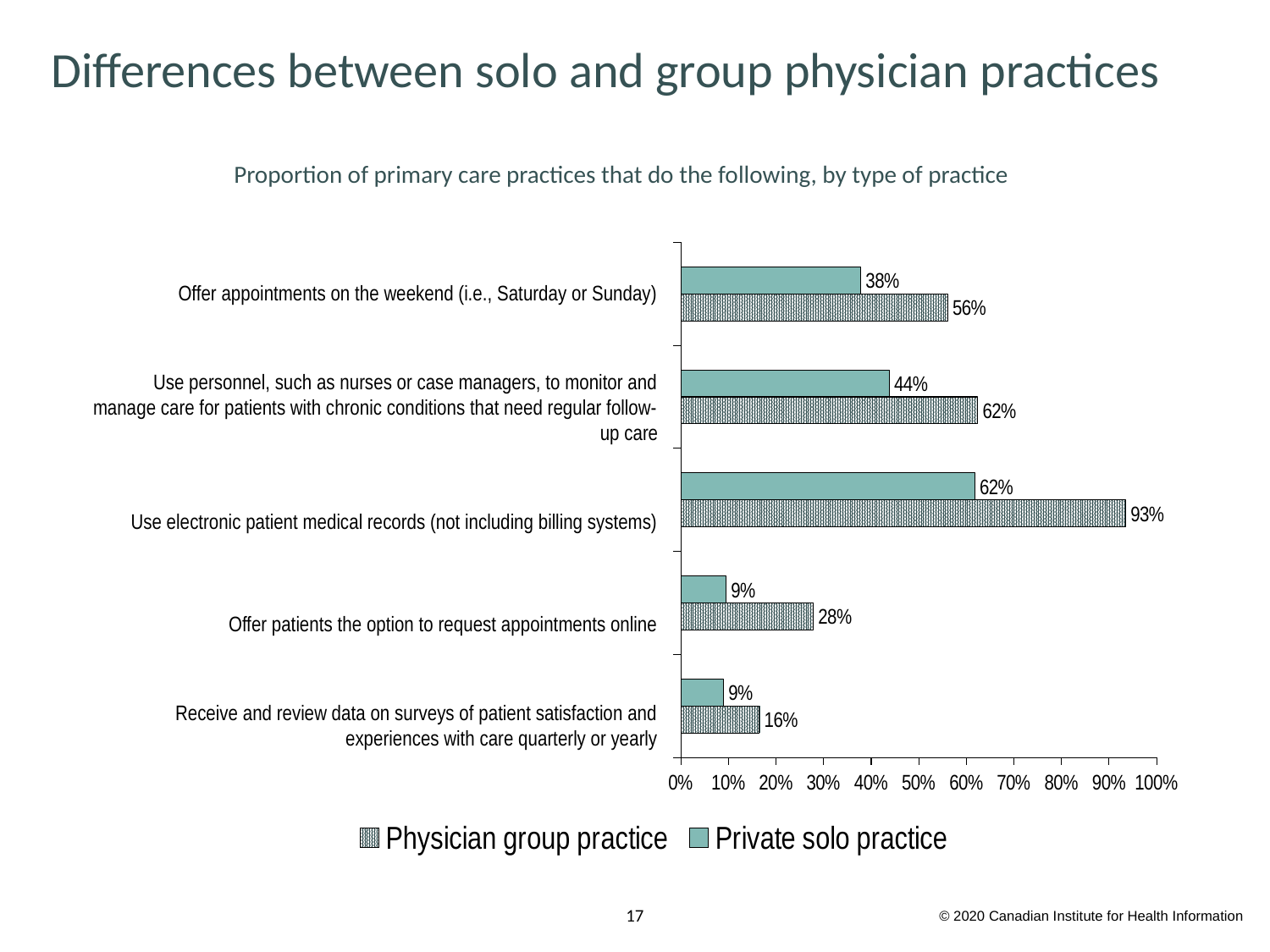
Which category has the highest value for physician group practice? Use electronic patient medical records (not including billing systems) For using personnel such as nurses or case managers to monitor and manage care for patients with chronic conditions, which is larger: physician group practice or private solo practice? Physician group practice How many categories are shown on the chart? 5 What percentage of physician group practices use electronic patient medical records (not including billing systems)? 93% Is the value for physician group practice using electronic patient medical records greater or less than 90%? greater What kind of chart is shown on the slide? Bar chart What percentage of private solo practices offer appointments on the weekend (i.e., Saturday or Sunday)? 38% How many series does the legend list? 2 What is the difference between physician group practice and private solo practice for using electronic patient medical records? 31% Which category has the lowest value for physician group practice? Receive and review data on surveys of patient satisfaction and experiences with care quarterly or yearly What percentage of physician group practices offer patients the option to request appointments online? 28% What is the difference between physician group practice and private solo practice for offering appointments on the weekend? 18%